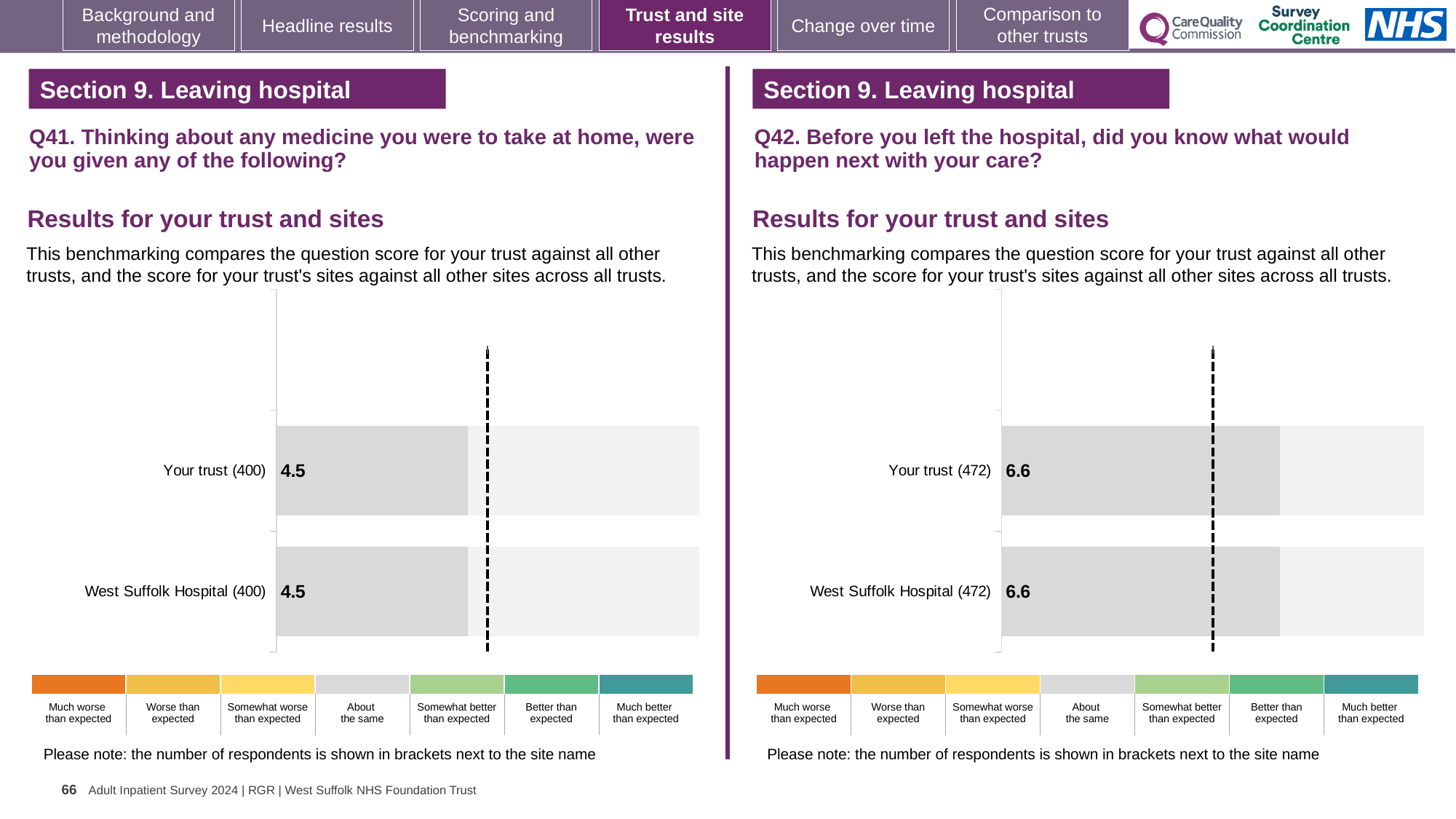
On the Q41 chart (left), what is the score for Your trust? 4.5 On the Q42 chart (right), what is the difference between the score for Your trust and the score for West Suffolk Hospital? 0 How many benchmark categories are listed in the colour key below the Q41 chart (left)? 7 On the Q41 chart (left), how many respondents are shown in brackets for Your trust? 400 How many bars are plotted on the Q41 chart (left)? 2 On the Q42 chart (right), how many respondents are shown in brackets for West Suffolk Hospital? 472 How many bars are plotted on the Q42 chart (right)? 2 On the Q42 chart (right), what is the score for West Suffolk Hospital? 6.6 What kind of chart is used on the Q42 chart (right)? Bar chart On the Q42 chart (right), what is the score for Your trust? 6.6 On the Q41 chart (left), what is the difference between the score for Your trust and the score for West Suffolk Hospital? 0 On the Q41 chart (left), what is the score for West Suffolk Hospital? 4.5